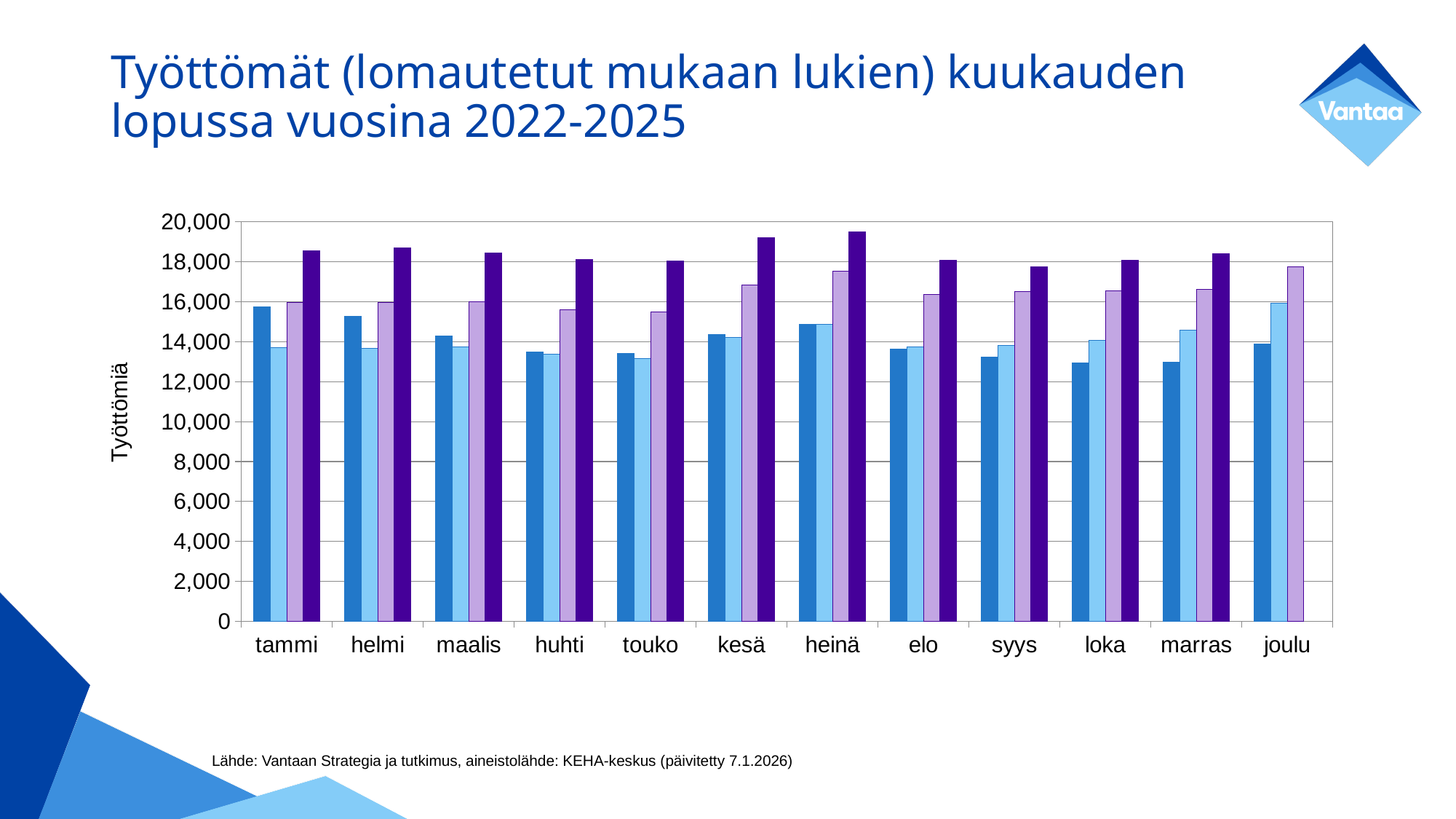
Is the shortest bar for loka greater or less than 14,000? less Which month has the single tallest bar in the chart? heinä Is the dark purple bar for kesä greater or less than 18,000? greater How many months (categories) are shown on the x axis? 12 What kind of chart is shown on the slide? bar chart What is the highest value shown on the vertical axis? 20,000 Is the tallest bar for heinä greater or less than 18,000? greater How many bars are plotted for each month? 4 (except joulu, which has 3) What is the label on the vertical axis? Työttömiä Is the tallest bar for heinä taller or shorter than the tallest bar for elo? taller